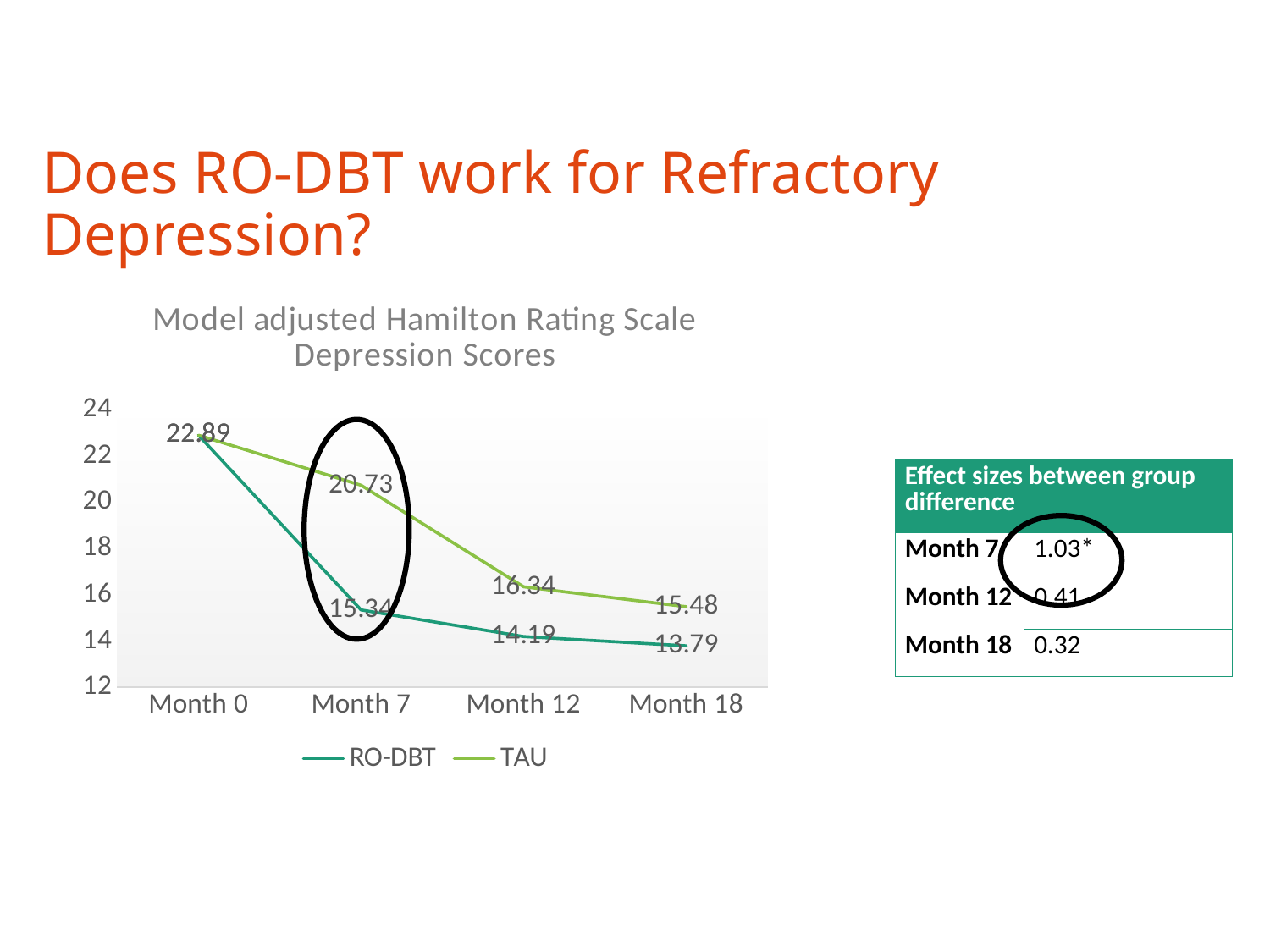
What type of chart is shown on the slide? line chart Do the RO-DBT scores rise or fall from Month 0 to Month 18? fall What is the RO-DBT score at Month 12? 14.19 Is the TAU score at Month 12 greater or less than 18? less How many series does the chart legend list? 2 Which series has the higher score at Month 7, RO-DBT or TAU? TAU What is the difference between the TAU and RO-DBT scores at Month 12? 2.15 What is the TAU score at Month 7? 20.73 How many time points are plotted along the x axis? 4 What is the TAU score at Month 18? 15.48 What is the RO-DBT score at Month 18? 13.79 What is the title of the chart? Model adjusted Hamilton Rating Scale Depression Scores